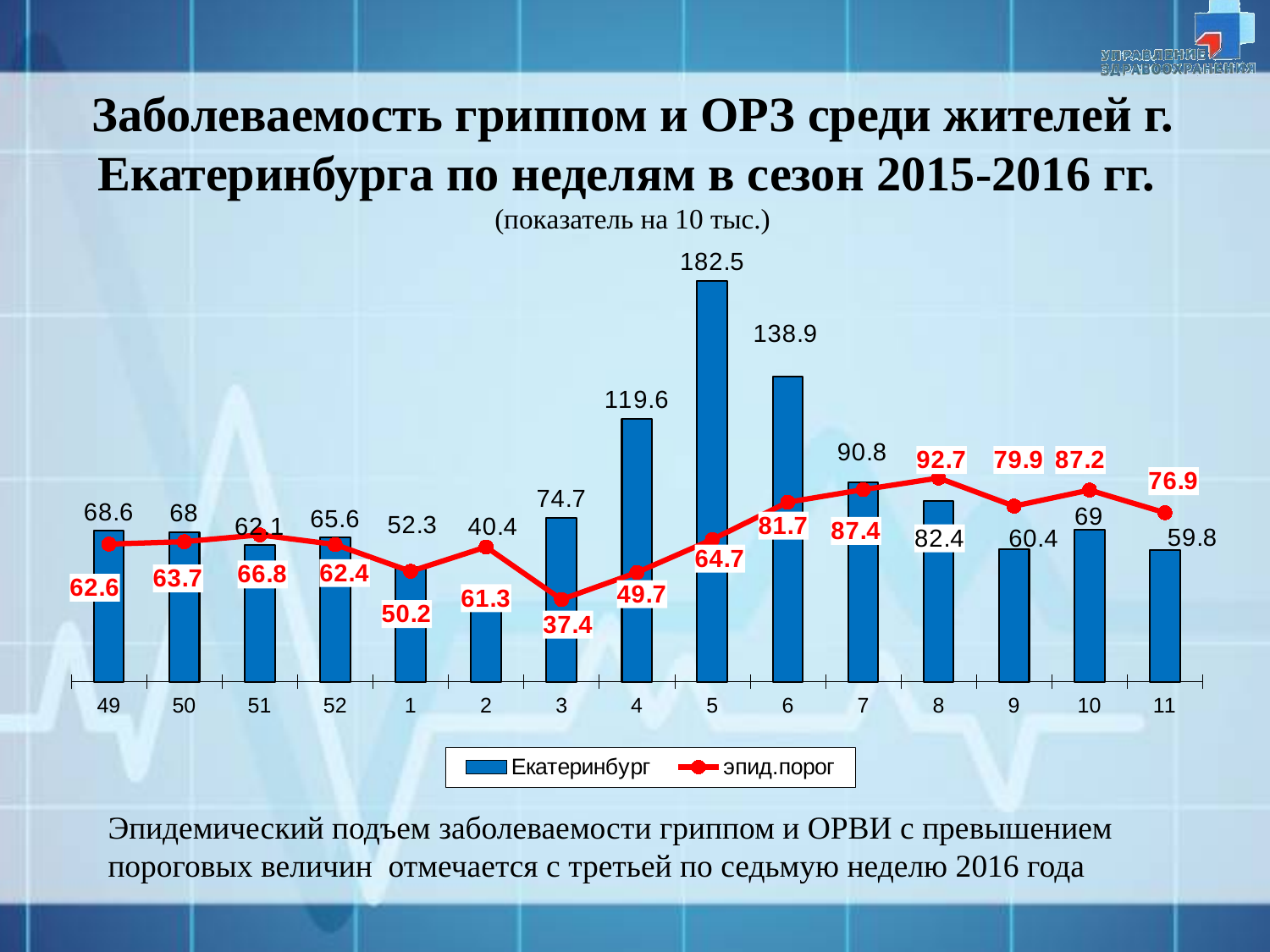
For week 9, which is larger: the Екатеринбург value or the эпид.порог value? эпид.порог How many series does the legend list? 2 Which week has the lowest эпид.порог value? 3 What is the Екатеринбург value for week 2? 40.4 How many weeks are shown on the x axis? 15 Which week has the lowest Екатеринбург value? 2 What is the difference between the Екатеринбург value and the эпид.порог value for week 5? 117.8 What is the Екатеринбург value for week 5? 182.5 What is the эпид.порог value for week 3? 37.4 What is the эпид.порог value for week 8? 92.7 Which week has the highest Екатеринбург value? 5 What kind of chart is shown on the slide? Combined bar and line chart